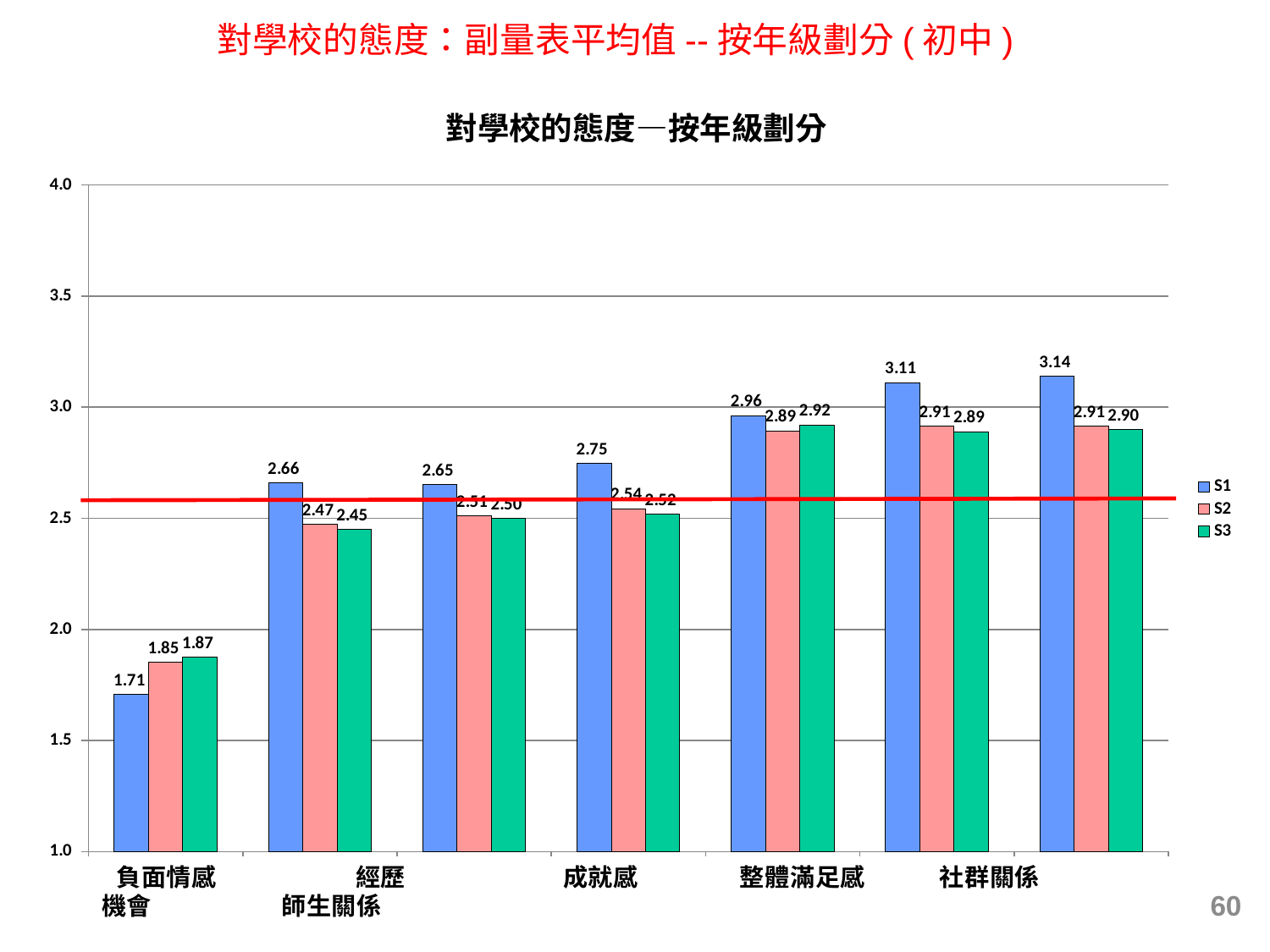
How many groups of bars are plotted in the chart? 7 What are the entries listed in the legend? S1, S2, S3 What is the S1 value for 負面情感? 1.71 How many series does the legend list? 3 What kind of chart is shown on the slide? bar chart Which category has the lowest S1 value? 負面情感